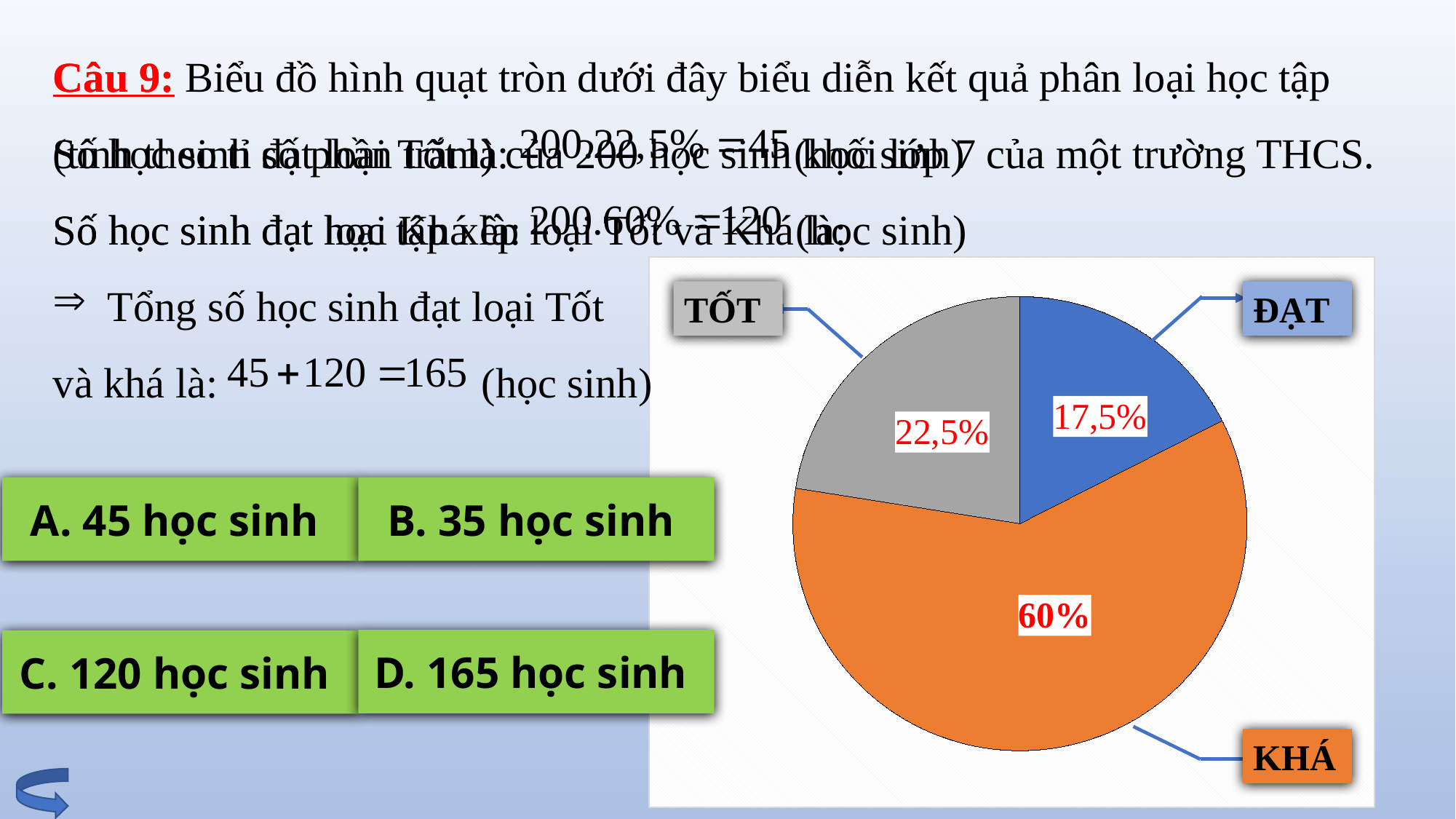
What kind of chart is shown on the slide? pie chart What percentage of the pie chart is the ĐẠT slice? 17,5% How many slices does the pie chart have? 3 What colour is the KHÁ slice in the pie chart? orange Which category has the smallest slice in the pie chart? ĐẠT What is the difference in percentage points between the KHÁ slice and the TỐT slice? 37,5% What percentage of the pie chart is the KHÁ slice? 60% What colour is the TỐT slice in the pie chart? grey Which category has the largest slice in the pie chart? KHÁ What is the difference in percentage points between the TỐT slice and the ĐẠT slice? 5% Which slice is larger, TỐT or ĐẠT? TỐT What percentage of the pie chart is the TỐT slice? 22,5%